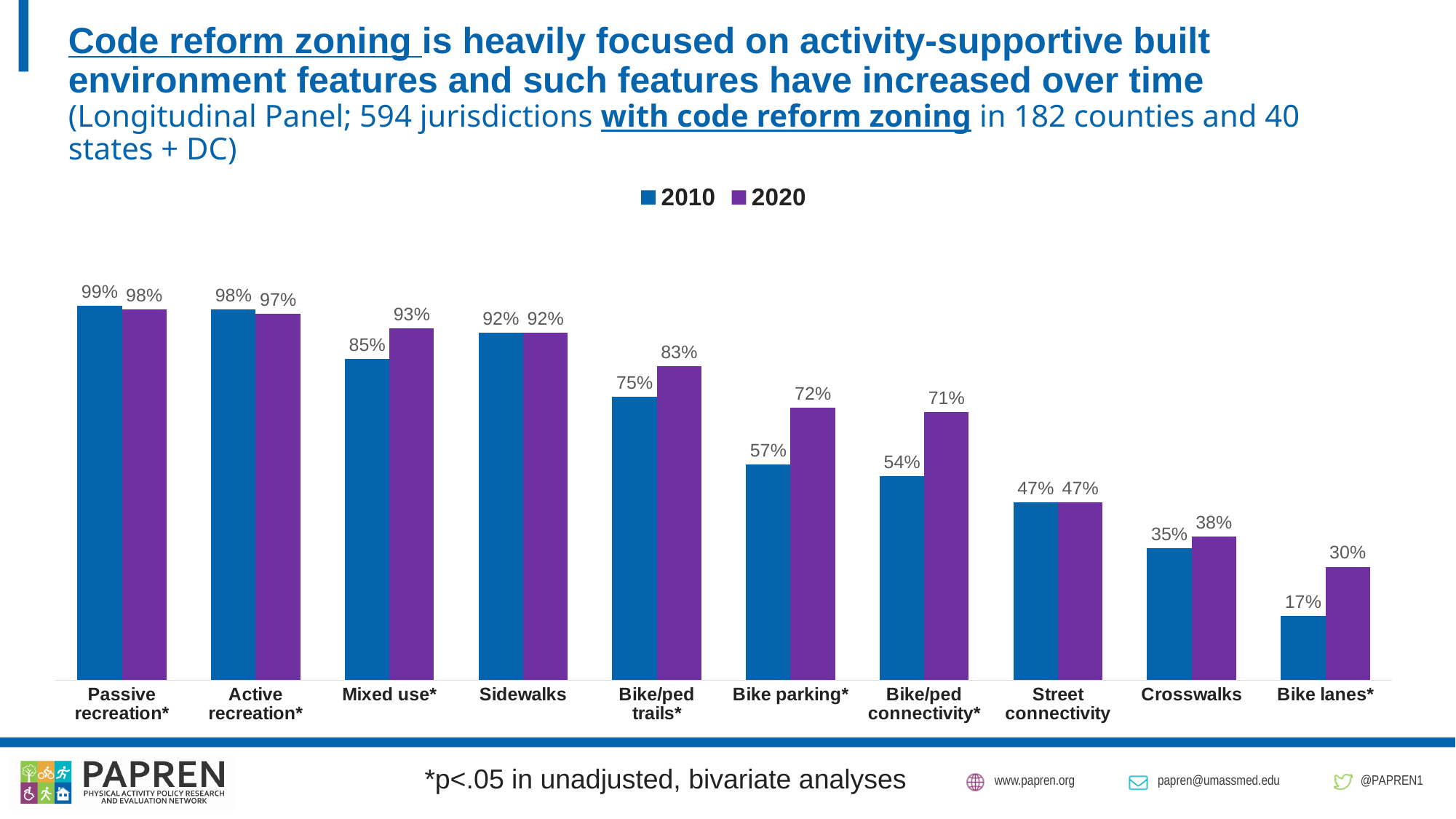
How many series does the legend list? 2 What kind of chart is shown on the slide? Bar chart Do the 2010 values generally rise or fall from left to right along the x axis? Fall Which series is shown in purple in the legend? 2020 What is the 2010 value for Bike lanes*? 17% What is the 2010 value for Bike/ped trails*? 75% Which category has the highest 2010 value? Passive recreation* Which category has the lowest 2020 value? Bike lanes* What is the 2020 value for Bike parking*? 72% Which is larger for Mixed use*: the 2010 value or the 2020 value? 2020 How many categories are shown on the x axis? 10 What is the difference between the 2020 and 2010 values for Bike/ped connectivity*? 17%